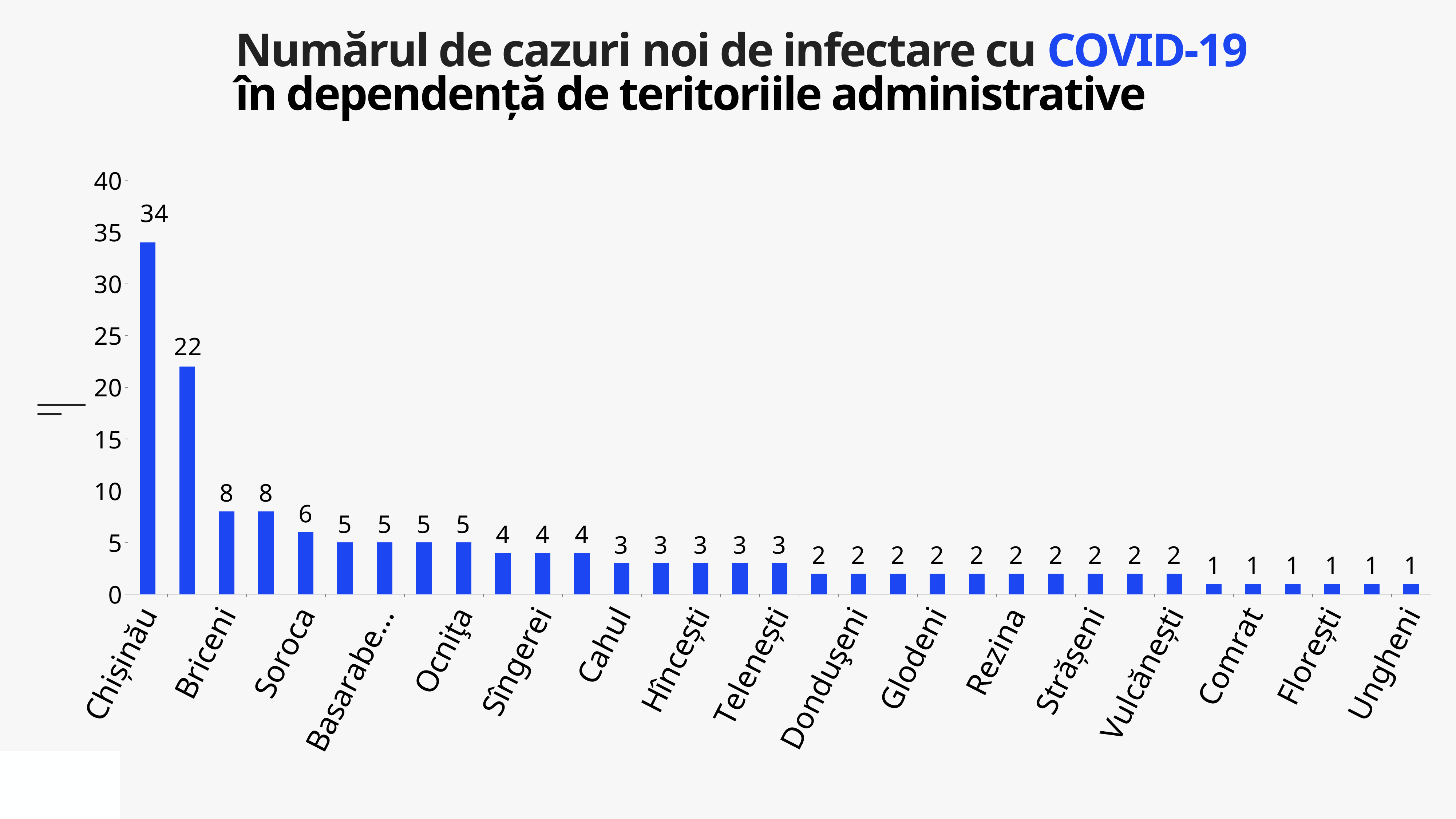
What is the number of new cases shown for Ungheni? 1 What is the number of new COVID-19 cases shown for Chișinău? 34 Do the values rise or fall moving from left to right along the x axis? fall Which word in the chart title is printed in blue? COVID-19 Is the value for Chișinău greater or less than 30? greater How many bars are plotted in the chart? 33 Which has more new cases, Chișinău or Briceni? Chișinău What value is labelled on the second bar from the left? 22 What is the number of new cases shown for Briceni? 8 What kind of chart is shown on the slide? bar chart Which administrative territory has the highest number of new cases? Chișinău What is the difference between the first bar (34) and the second bar (22)? 12